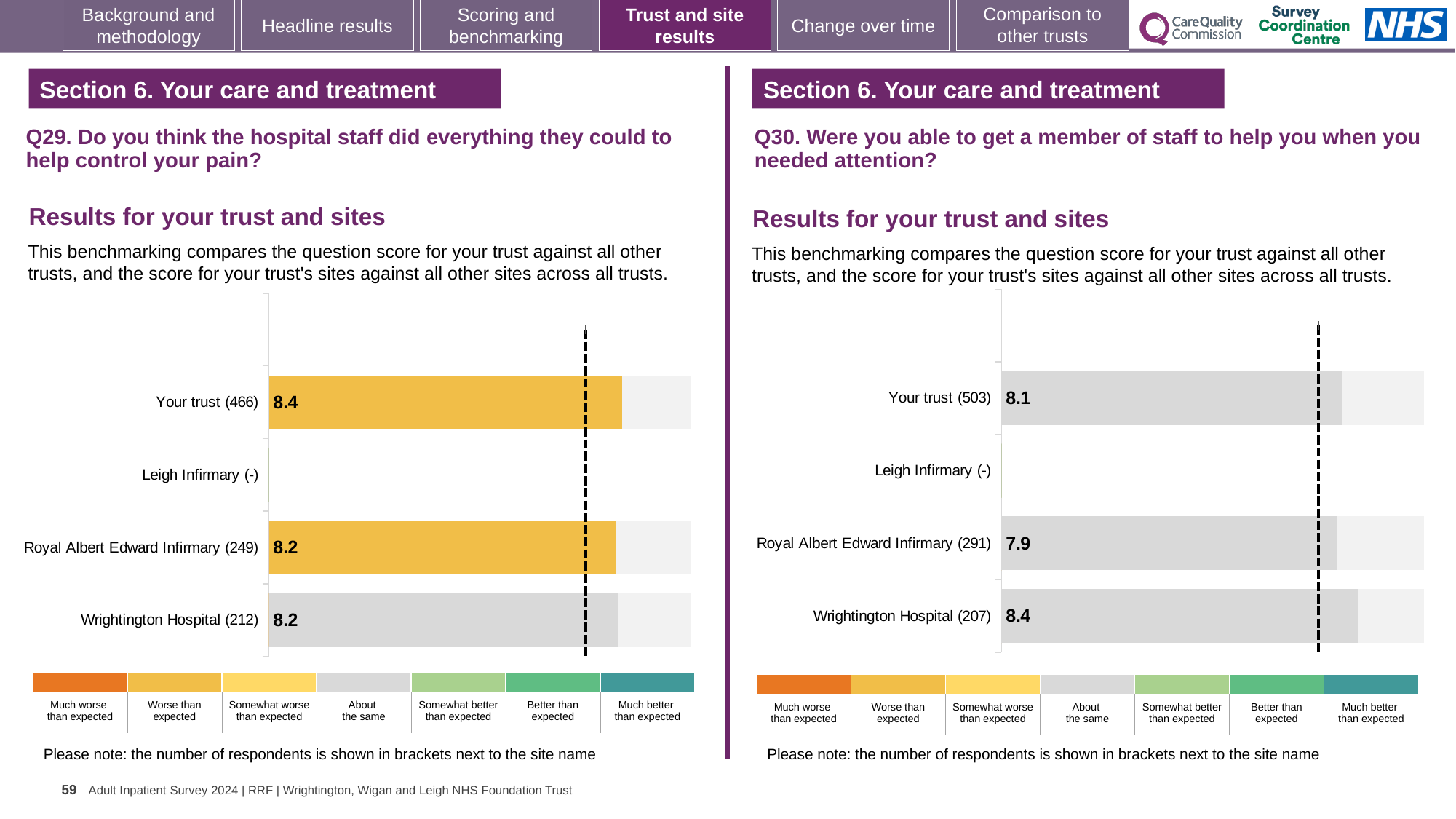
In the Q30 chart on the right, what is the score for Wrightington Hospital? 8.4 In the Q30 chart on the right, which site or trust has the lowest score? Royal Albert Edward Infirmary In the Q30 chart on the right, what is the difference between the scores for Wrightington Hospital and Royal Albert Edward Infirmary? 0.5 In the Q29 chart on the left, which benchmark category does the colour of the Your trust bar correspond to? Worse than expected In the Q29 chart on the left, which has the higher score: Your trust or Royal Albert Edward Infirmary? Your trust In the Q30 chart on the right, which site or trust has the highest score? Wrightington Hospital In the Q29 chart on the left, what is the score for Royal Albert Edward Infirmary? 8.2 In the Q29 chart on the left, what is the score for Your trust? 8.4 What kind of chart is used for the Q29 results on the left? Bar chart In the Q29 chart on the left, what is the difference between the scores for Your trust and Wrightington Hospital? 0.2 How many respondents are shown in brackets for Your trust in the Q30 chart on the right? 503 In the Q30 chart on the right, what is the score for Royal Albert Edward Infirmary? 7.9